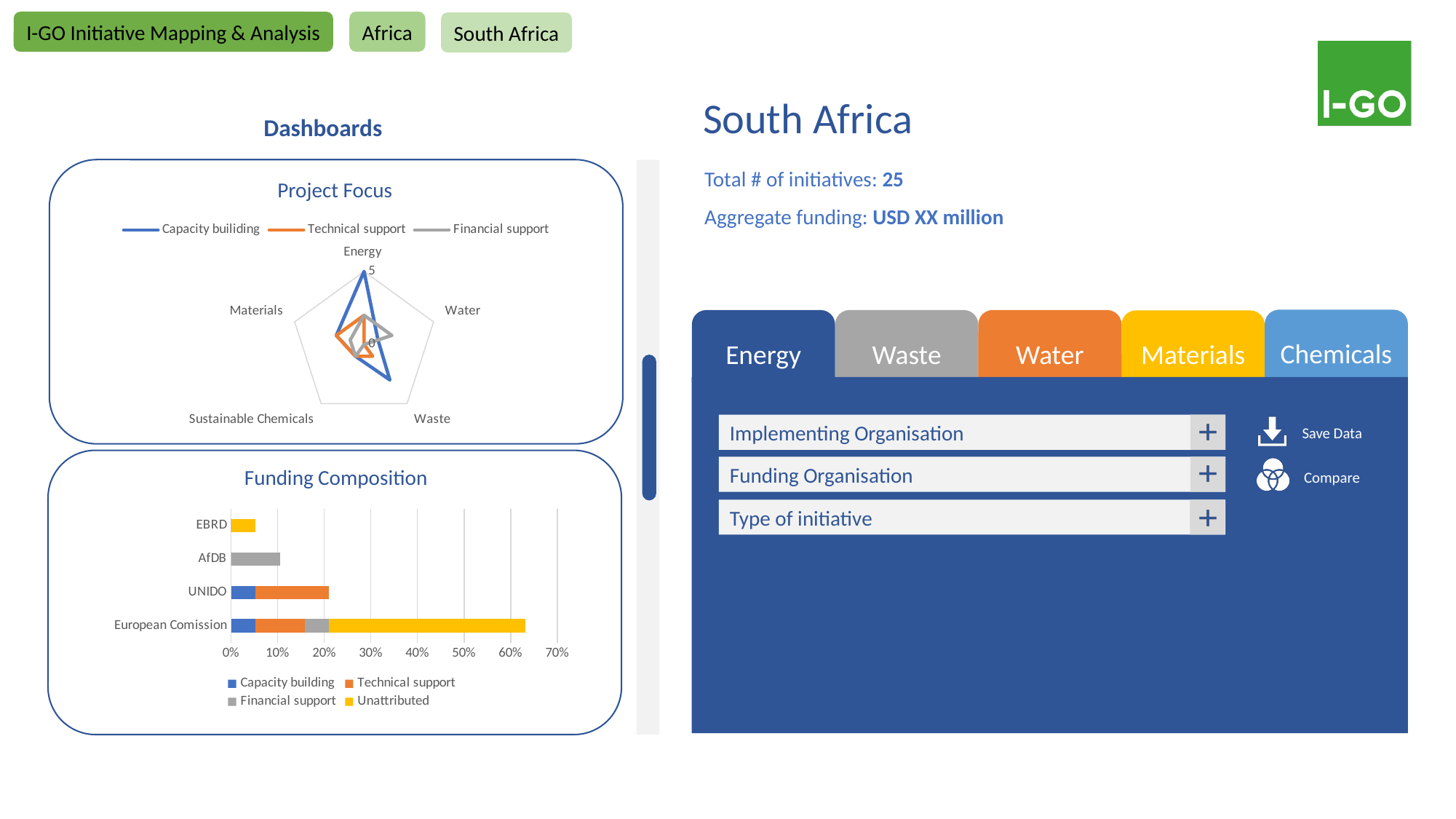
How many series does the legend of the Project Focus chart list? 3 In the Project Focus chart, what is the Capacity building value for Energy? 5 What kind of chart is the Funding Composition chart? bar chart How many series does the legend of the Funding Composition chart list? 4 In the Funding Composition chart, is the total value for European Comission greater or less than 50%? greater In the Funding Composition chart, which organisation has the shortest total bar? EBRD In the Funding Composition chart, which organisation has the longest total bar? European Comission How many categories (axes) does the Project Focus radar chart have? 5 How many organisations are shown in the Funding Composition chart? 4 In the Funding Composition chart, is the value for EBRD greater or less than 10%? less What kind of chart is the Project Focus chart? radar chart In the Project Focus chart, which category has the highest Capacity building value? Energy